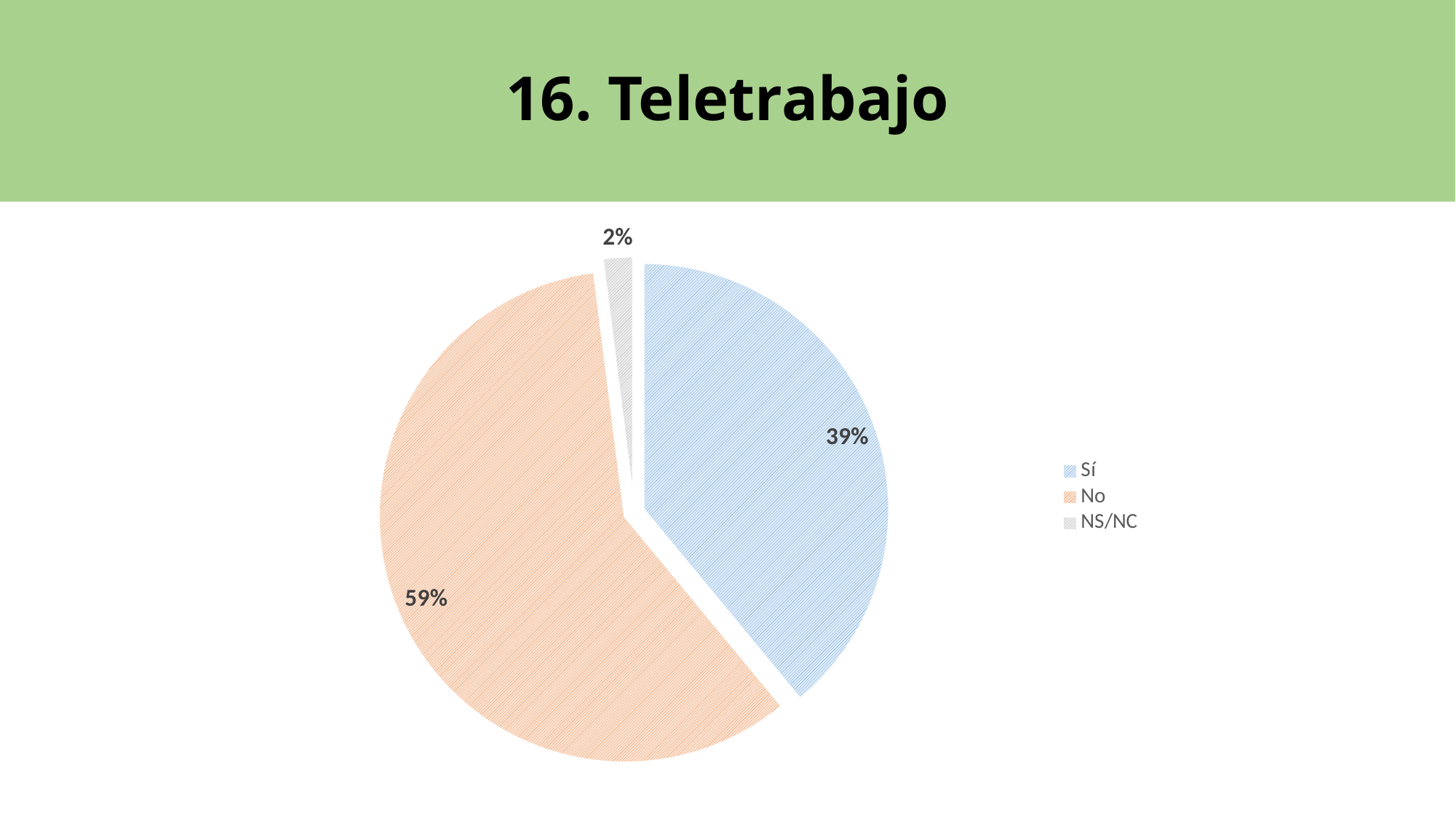
How many slices does the pie chart have? 3 Which category has the smallest slice of the pie? NS/NC What is the title of the slide containing the pie chart? 16. Teletrabajo Which legend entry is shown in orange? No Which slice is larger, "Sí" or "No"? No Which category has the largest slice of the pie? No What type of chart is shown on the slide? pie chart What percentage of the pie does the "Sí" slice represent? 39% What percentage of the pie does the "No" slice represent? 59% What percentage of the pie does the "NS/NC" slice represent? 2% What is the difference in percentage points between the "No" slice and the "Sí" slice? 20 How many entries does the legend list? 3